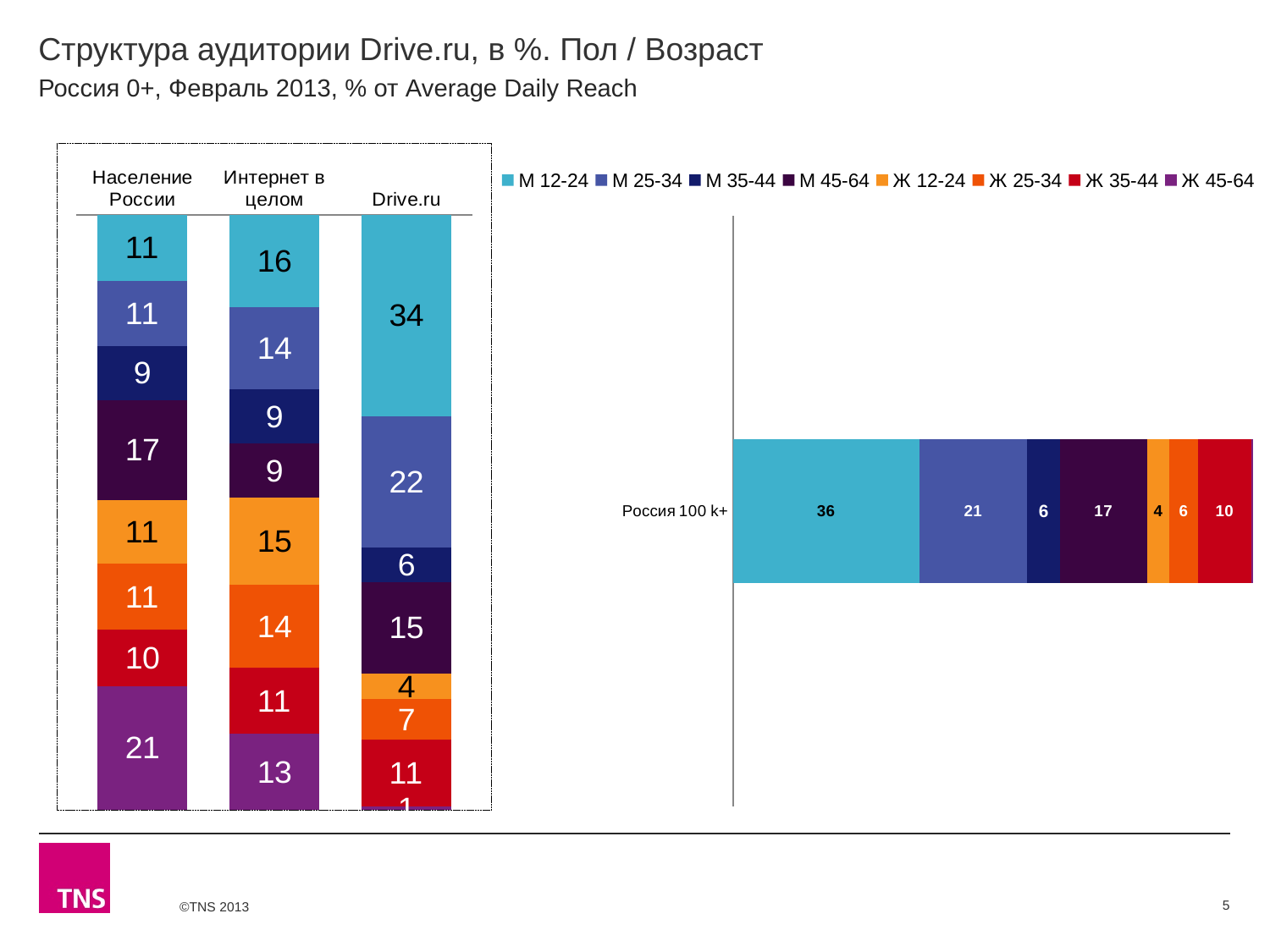
In the right chart, what is the value for М 12-24 for Россия 100 k+? 36 In the right chart, what is the value for М 45-64 for Россия 100 k+? 17 What kind of chart is the left chart? Stacked bar chart In the left chart, what is the total of the Drive.ru stacked bar? 100 In the left chart, what is the value for М 12-24 in the Drive.ru bar? 34 In the left chart, what is the difference between the М 12-24 value for Drive.ru and the М 12-24 value for Население России? 23 In the left chart, what is the value for Ж 45-64 in the Население России bar? 21 In the left chart, how many categories (bars) are shown? 3 In the left chart, which has the larger Ж 12-24 value: Интернет в целом or Население России? Интернет в целом What is the category label shown on the right chart? Россия 100 k+ In the left chart, which category has the highest М 12-24 value? Drive.ru How many series does the legend list? 8